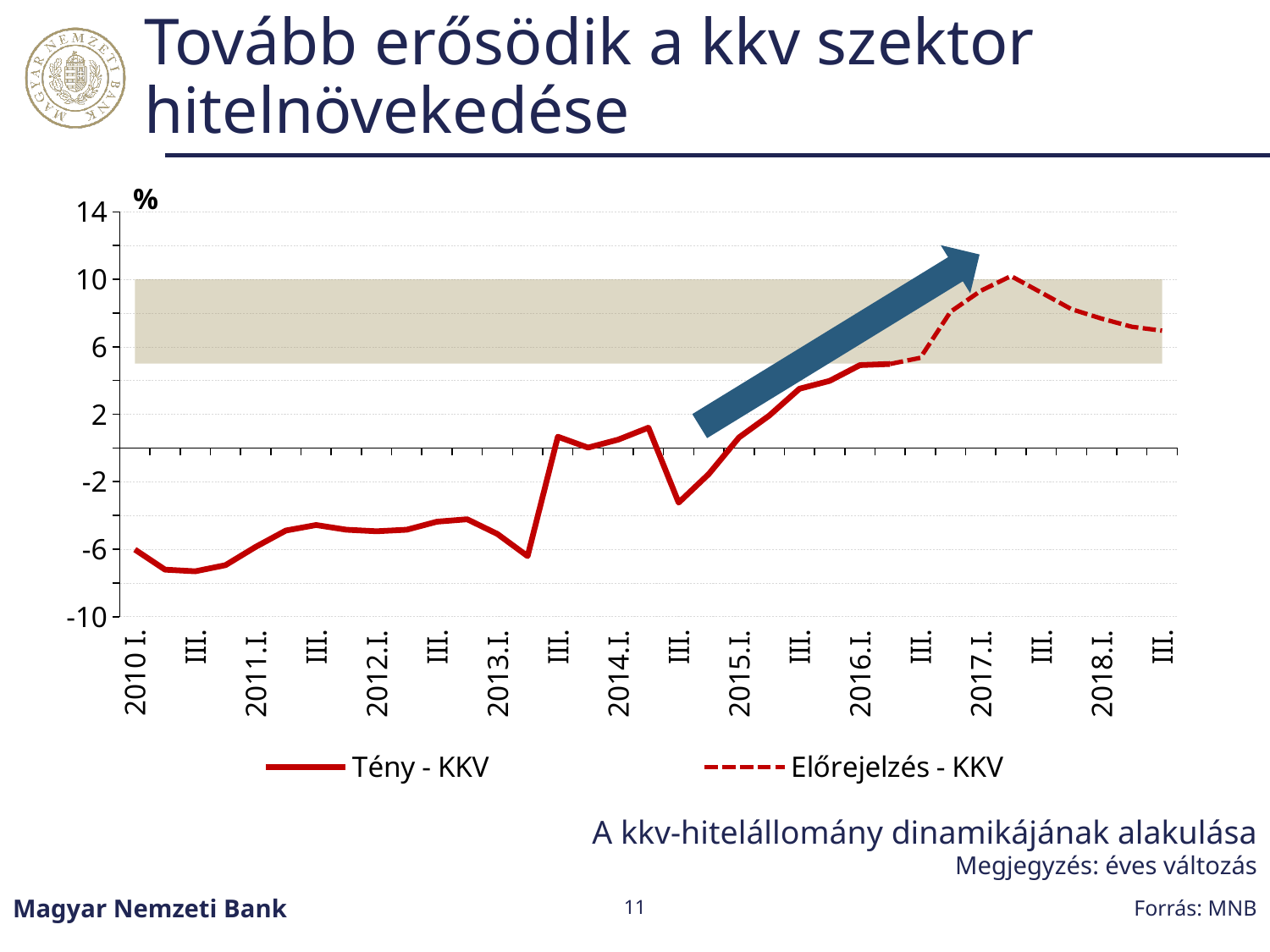
Is the value of Előrejelzés - KKV at 2018 III. greater or less than 2? greater Is the value of Tény - KKV at 2013 I. greater or less than -2? less Is the value of Tény - KKV at 2014 III. greater or less than -2? less What are the two series named in the legend? Tény - KKV and Előrejelzés - KKV What unit is shown at the top of the vertical axis? % Does the Előrejelzés - KKV line rise or fall from 2017 I. to 2018 III.? fall What kind of chart is shown on the slide? line chart How many series does the legend list? 2